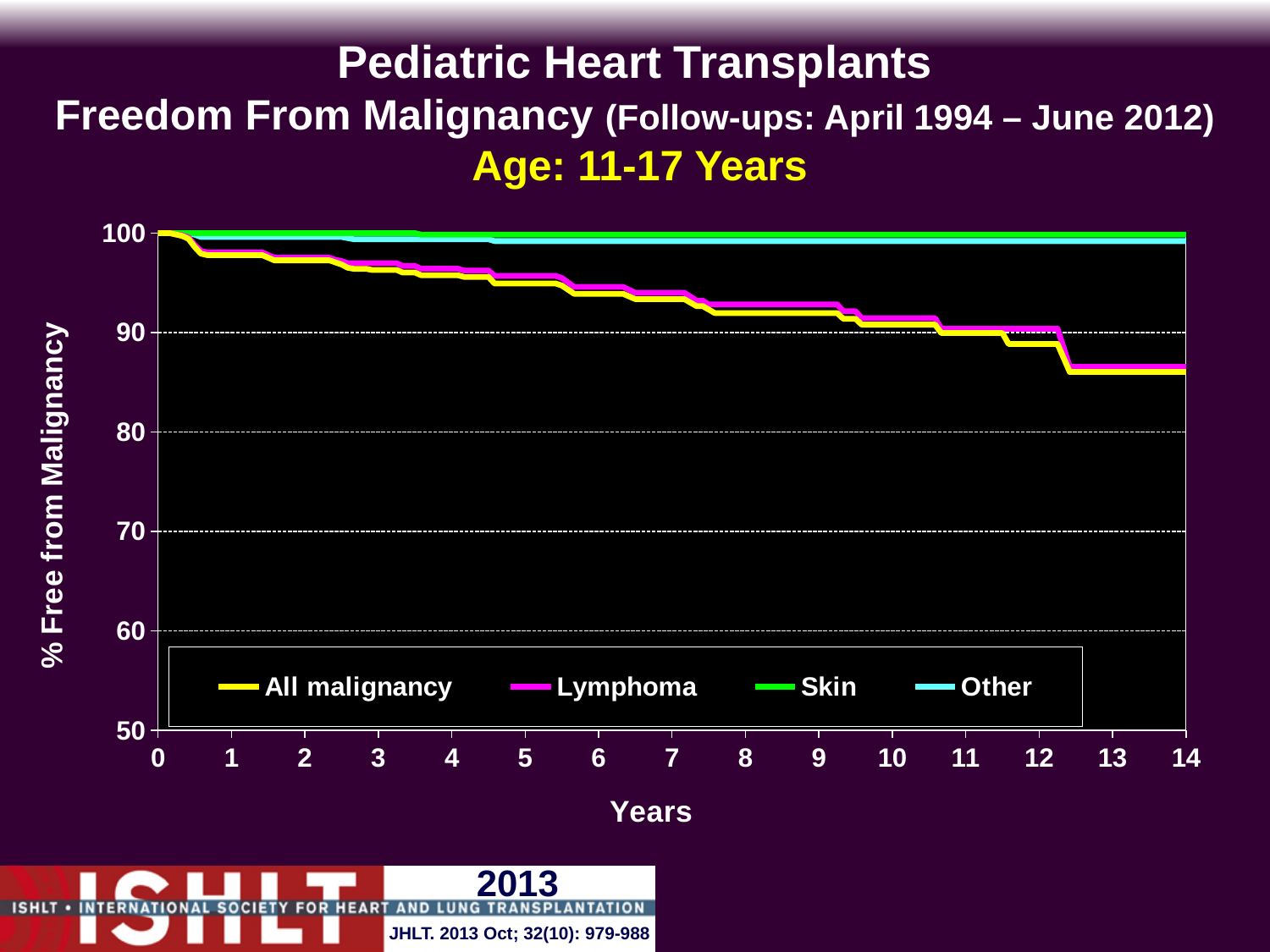
Is the value for All malignancy at 14 years greater or less than 90? less What is the label of the y axis? % Free from Malignancy Does the All malignancy curve rise or fall as years increase? fall Is the value for Lymphoma at 14 years greater or less than 90? less Is the value for Skin at 14 years greater or less than 90? greater How many series does the legend list? 4 Which series are listed in the legend? All malignancy, Lymphoma, Skin, Other What kind of chart is shown on the slide? line chart At 14 years, which is higher: Skin or All malignancy? Skin At 12 years, which is higher: Other or Lymphoma? Other